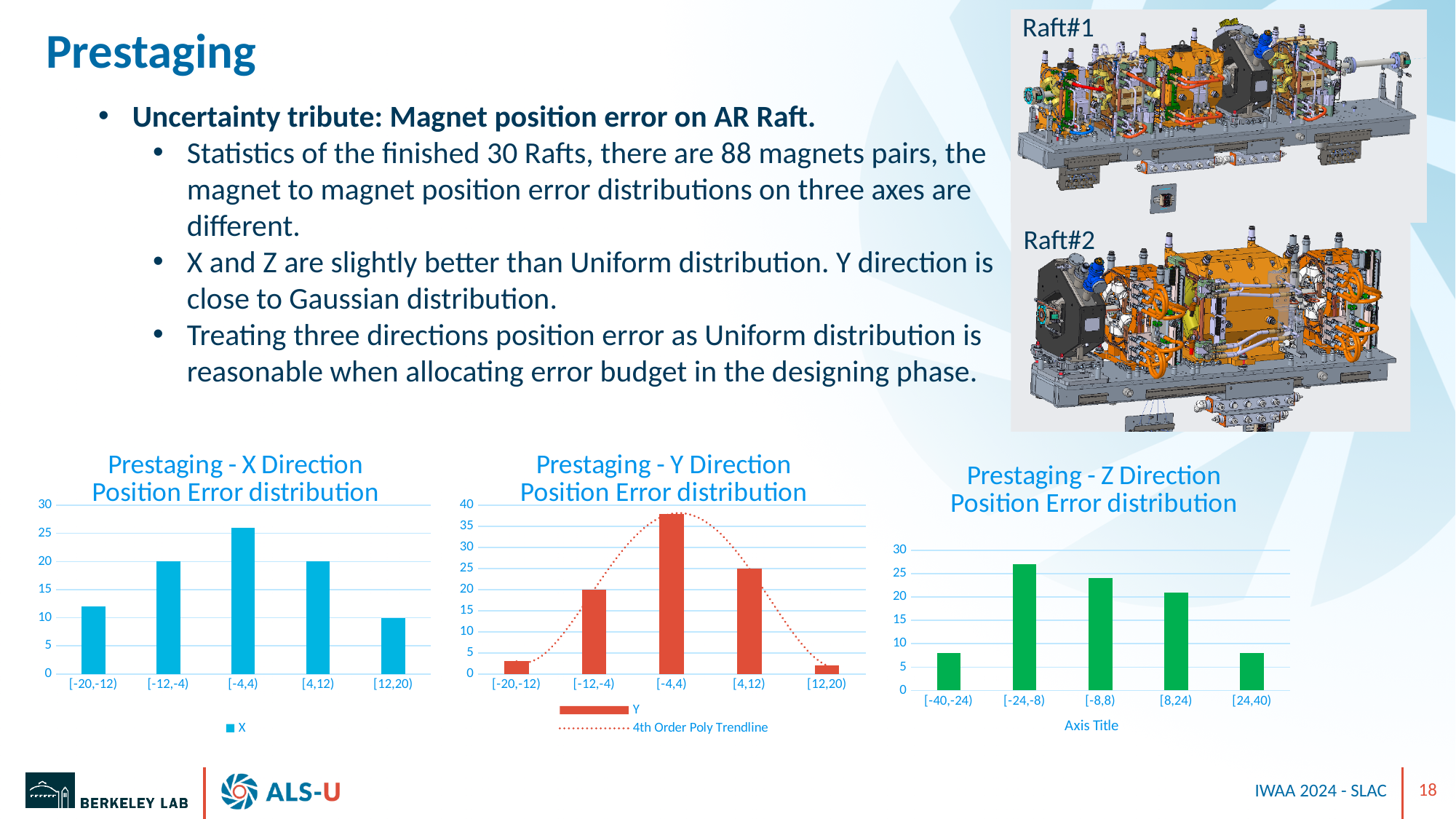
In the 'Prestaging - Y Direction Position Error distribution' chart, is the value for [-12,-4] larger or smaller than the value for [4,12]? smaller In the 'Prestaging - X Direction Position Error distribution' chart, is the value for [-20,-12] greater or less than 15? less In the 'Prestaging - Z Direction Position Error distribution' chart, is the value for [24,40] greater or less than 10? less In the 'Prestaging - X Direction Position Error distribution' chart, which category has the lowest value? [12,20) In the 'Prestaging - Z Direction Position Error distribution' chart, which category has the highest value? [-24,-8) What kind of chart is the 'Prestaging - Z Direction Position Error distribution' chart? bar chart How many entries does the legend of the 'Prestaging - Y Direction Position Error distribution' chart list? 2 In the 'Prestaging - Y Direction Position Error distribution' chart, which category has the highest value? [-4,4) In the 'Prestaging - Y Direction Position Error distribution' chart, is the value for [-4,4] greater or less than 35? greater In the 'Prestaging - X Direction Position Error distribution' chart, which category has the highest value? [-4,4) What is the name of the dotted line in the legend of the 'Prestaging - Y Direction Position Error distribution' chart? 4th Order Poly Trendline In the 'Prestaging - X Direction Position Error distribution' chart, how many categories are shown on the x axis? 5